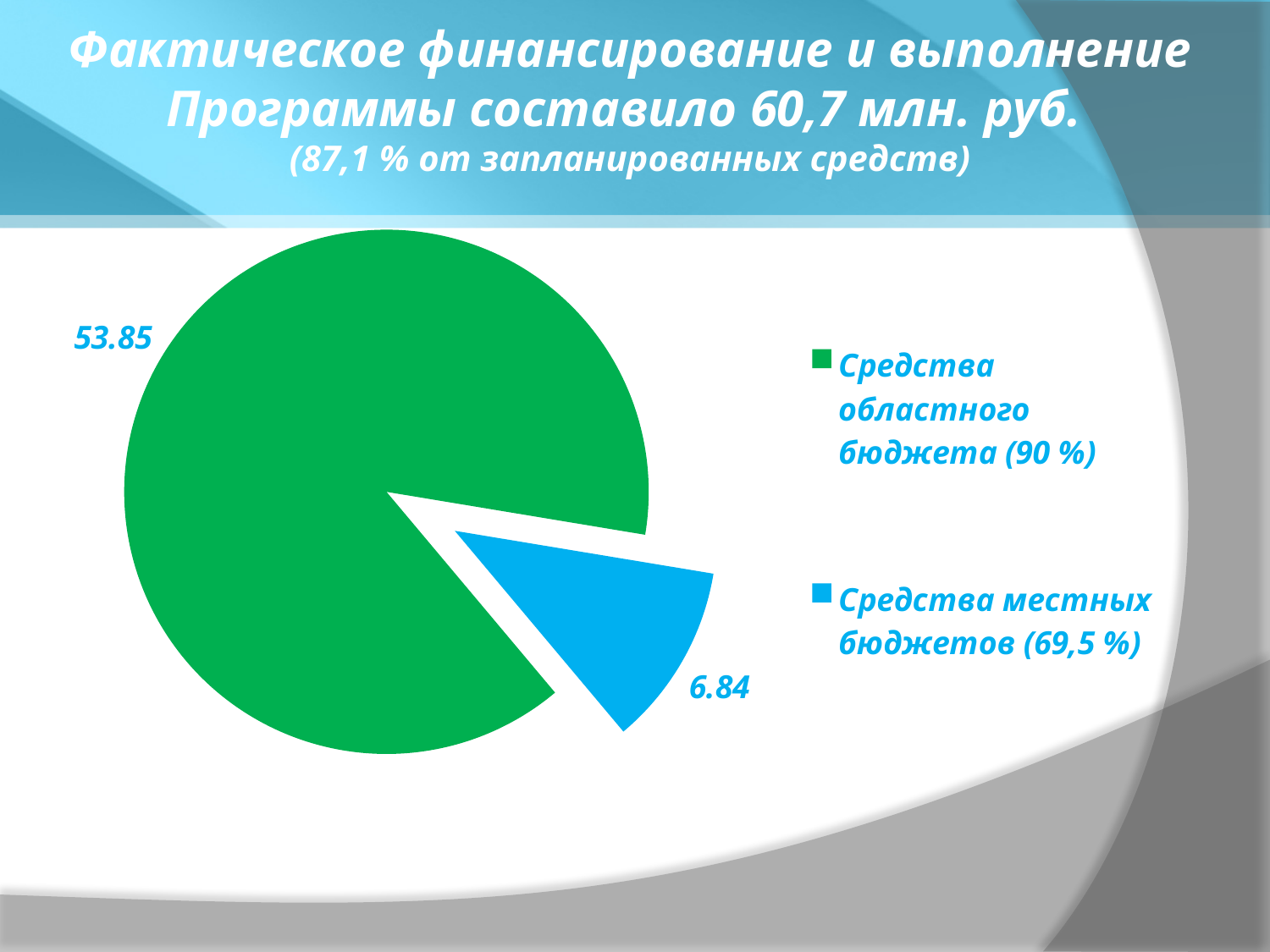
What is the difference between the value for Средства областного бюджета (90 %) and the value for Средства местных бюджетов (69,5 %)? 47.01 How many slices does the pie chart have? 2 What is the value for Средства областного бюджета (90 %)? 53.85 What colour is the slice for Средства местных бюджетов (69,5 %)? blue What is the value for Средства местных бюджетов (69,5 %)? 6.84 What is the total of the two slice values in the pie chart? 60.69 Which is larger: the value for Средства областного бюджета (90 %) or the value for Средства местных бюджетов (69,5 %)? Средства областного бюджета (90 %) How many entries does the legend list? 2 What kind of chart is shown on the slide? pie chart Which category has the smallest slice of the pie? Средства местных бюджетов (69,5 %) What share of the pie does Средства местных бюджетов (69,5 %) represent, to one decimal place? 11.3% Which category has the largest slice of the pie? Средства областного бюджета (90 %)